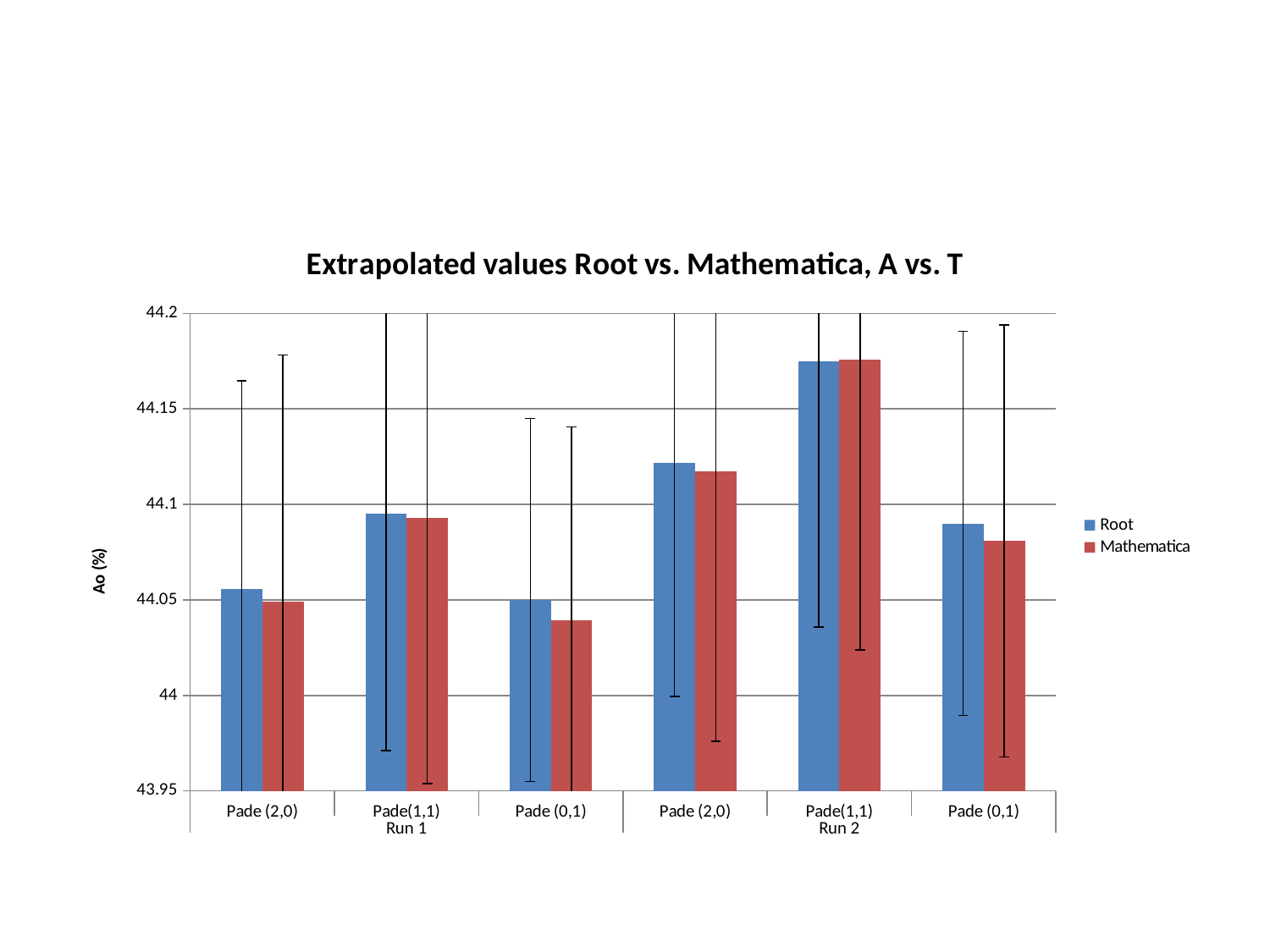
For which category is the Root value highest? Pade(1,1) in Run 2 How many categories are shown along the x axis? 6 Is the Mathematica value for Pade (0,1) in Run 1 greater or less than 44.05? less Which is larger: the Root value for Pade (2,0) in Run 2 or the Root value for Pade(1,1) in Run 1? Pade (2,0) in Run 2 Is the Root value for Pade(1,1) in Run 2 greater or less than 44.15? greater Is the Mathematica value for Pade (2,0) in Run 2 greater or less than 44.1? greater What is the title of the chart? Extrapolated values Root vs. Mathematica, A vs. T For Pade (0,1) in Run 1, which series has the larger value, Root or Mathematica? Root What kind of chart is shown on the slide? bar chart For which category is the Mathematica value lowest? Pade (0,1) in Run 1 How many series does the legend list? 2